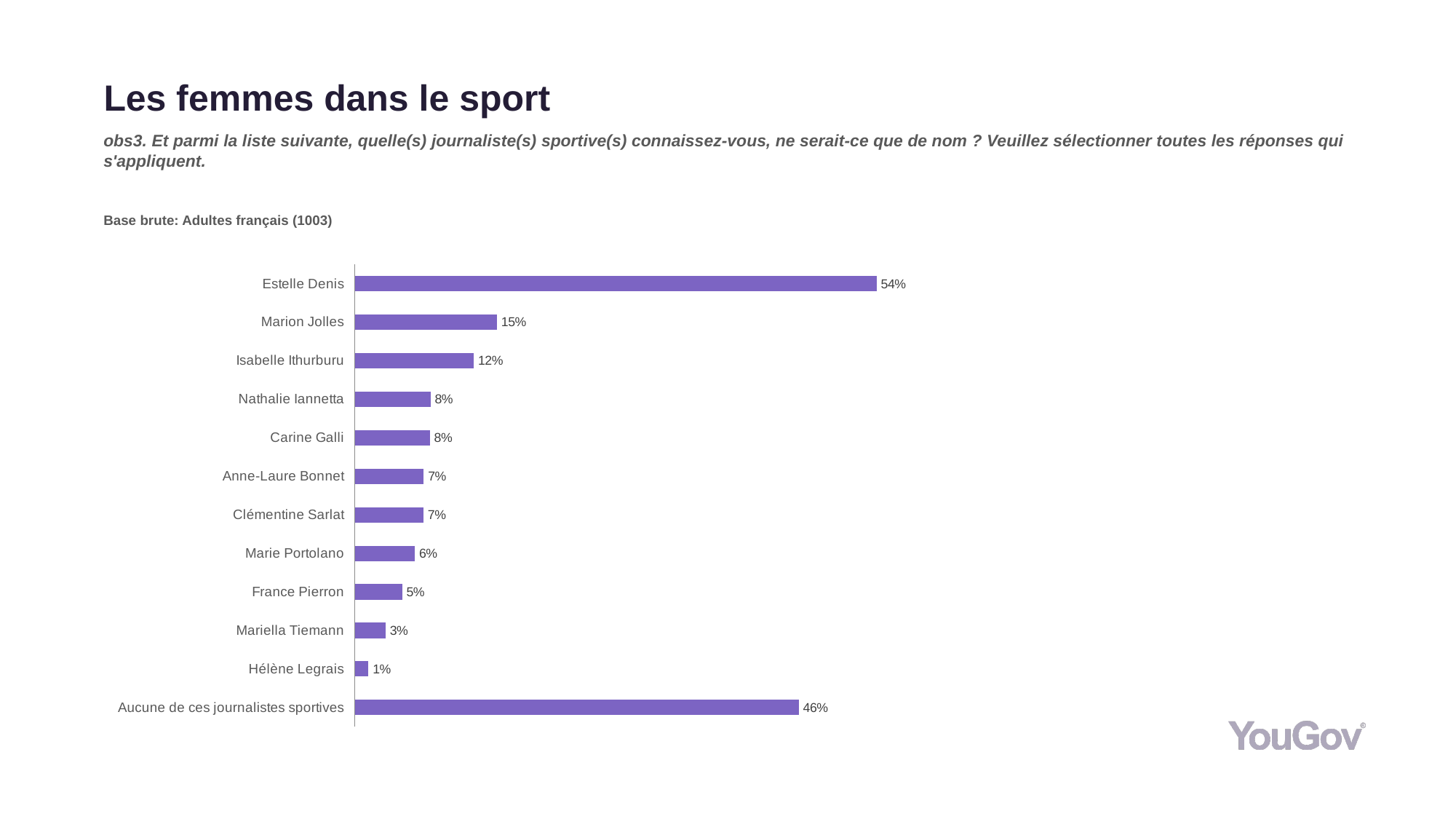
What is the difference between the values for Estelle Denis and 'Aucune de ces journalistes sportives'? 8 percentage points How many categories are shown in the chart? 12 What is the value shown for Marion Jolles? 15% What is the value shown for Isabelle Ithurburu? 12% Which has a larger value, Marie Portolano or France Pierron? Marie Portolano What percentage of respondents know Estelle Denis? 54% What is the base (sample) described on the slide? Adultes français (1003) What kind of chart is shown on the slide? Bar chart Which journalist has the lowest value in the chart? Hélène Legrais What is the difference between the values for Estelle Denis and Marion Jolles? 39 percentage points Which category has the highest value in the chart? Estelle Denis What percentage is shown for 'Aucune de ces journalistes sportives'? 46%